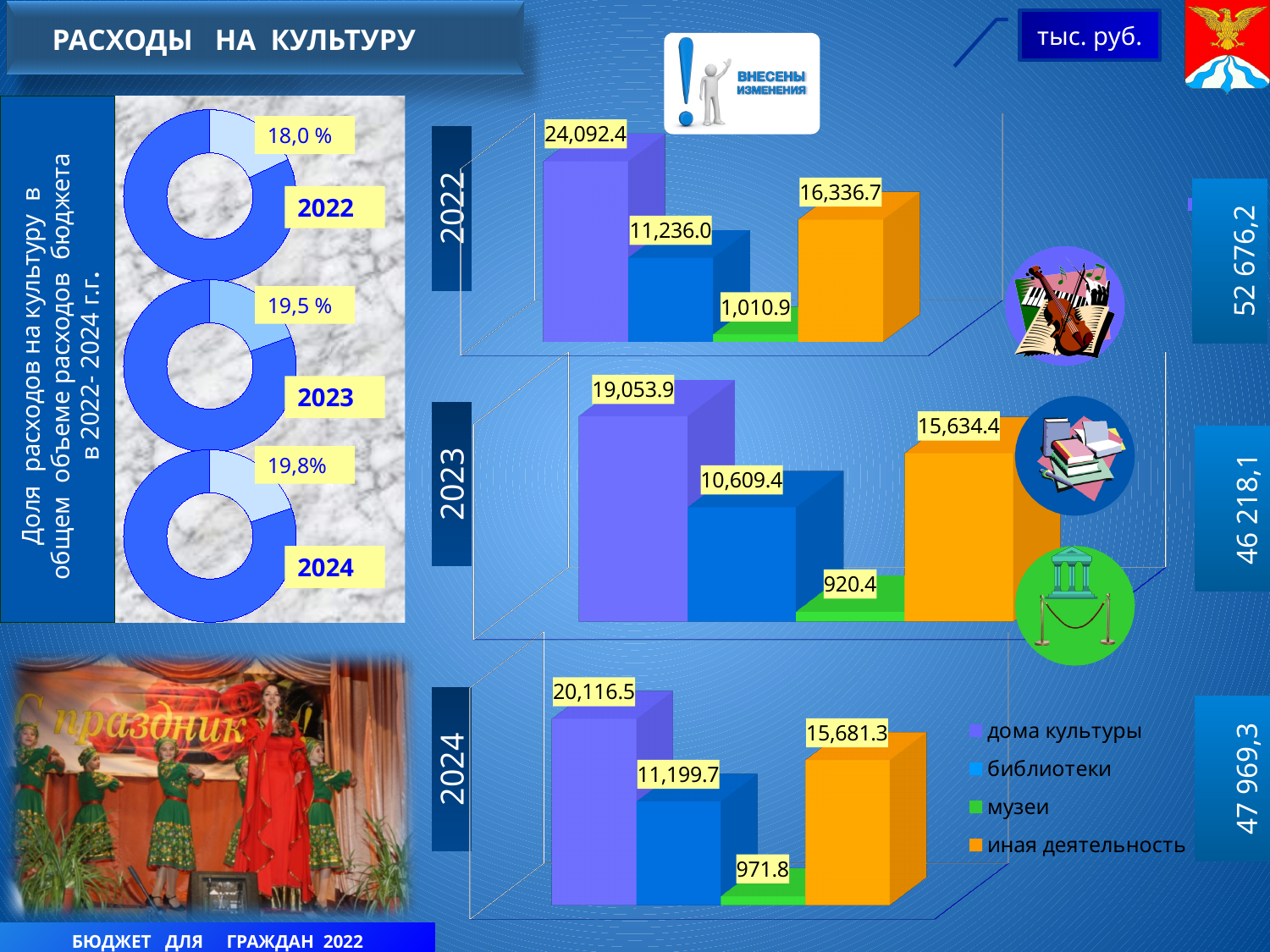
In the donut chart for 2023, what share of total budget expenditure goes to culture? 19,5 % In the 2022 bar chart, which is larger: библиотеки or иная деятельность? иная деятельность In the 2024 bar chart, what is the value for музеи? 971.8 In the 2022 bar chart, which category has the lowest value? музеи What colour represents иная деятельность in the bar charts? orange In the 2023 bar chart, what is the difference between дома культуры and иная деятельность? 3,419.5 What kind of chart is used to show the 2022, 2023 and 2024 expenditure breakdowns? bar chart In the 2024 bar chart, which category has the highest value? дома культуры In the 2022 bar chart, what is the value for дома культуры? 24,092.4 In the 2023 bar chart, what is the value for библиотеки? 10,609.4 In the donut chart for 2024, what percentage is shown? 19,8% How many categories does the legend of the bar charts list? 4